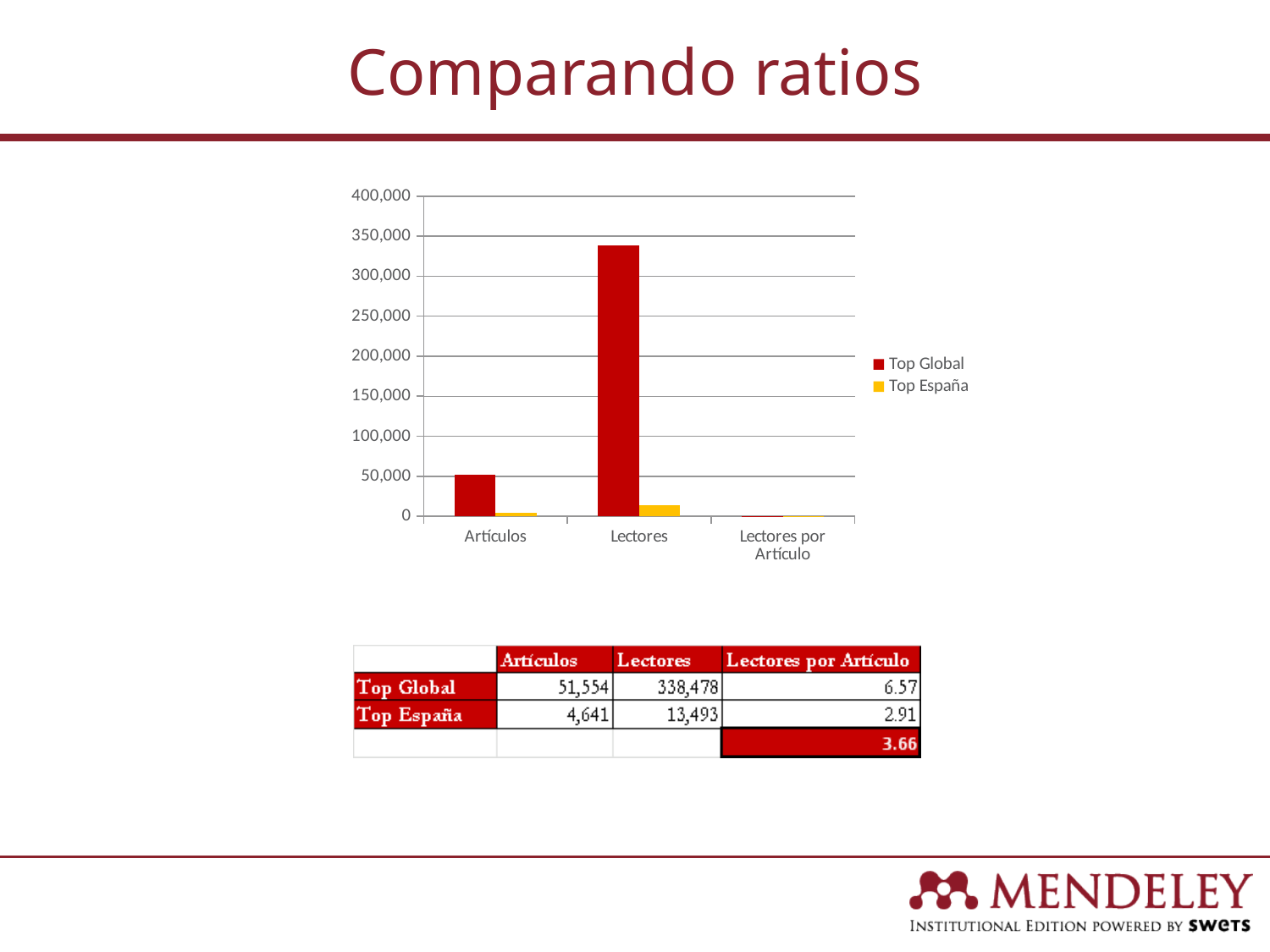
Is the value for Top Global in the Lectores category greater or less than 300,000? greater What is the value for Top Global in the Lectores category? 338,478 How many categories are shown on the x axis of the chart? 3 What is the value for Top España in the Lectores category? 13,493 Which category has the lowest value for the Top España series? Lectores por Artículo Which category has the highest value for the Top Global series? Lectores What kind of chart is shown on the slide? bar chart Which is larger in the Artículos category, Top Global or Top España? Top Global What colour are the bars for the Top España series? yellow How many series does the chart legend list? 2 What is the value for Top España in the Artículos category? 4,641 What is the value for Top Global in the Artículos category? 51,554